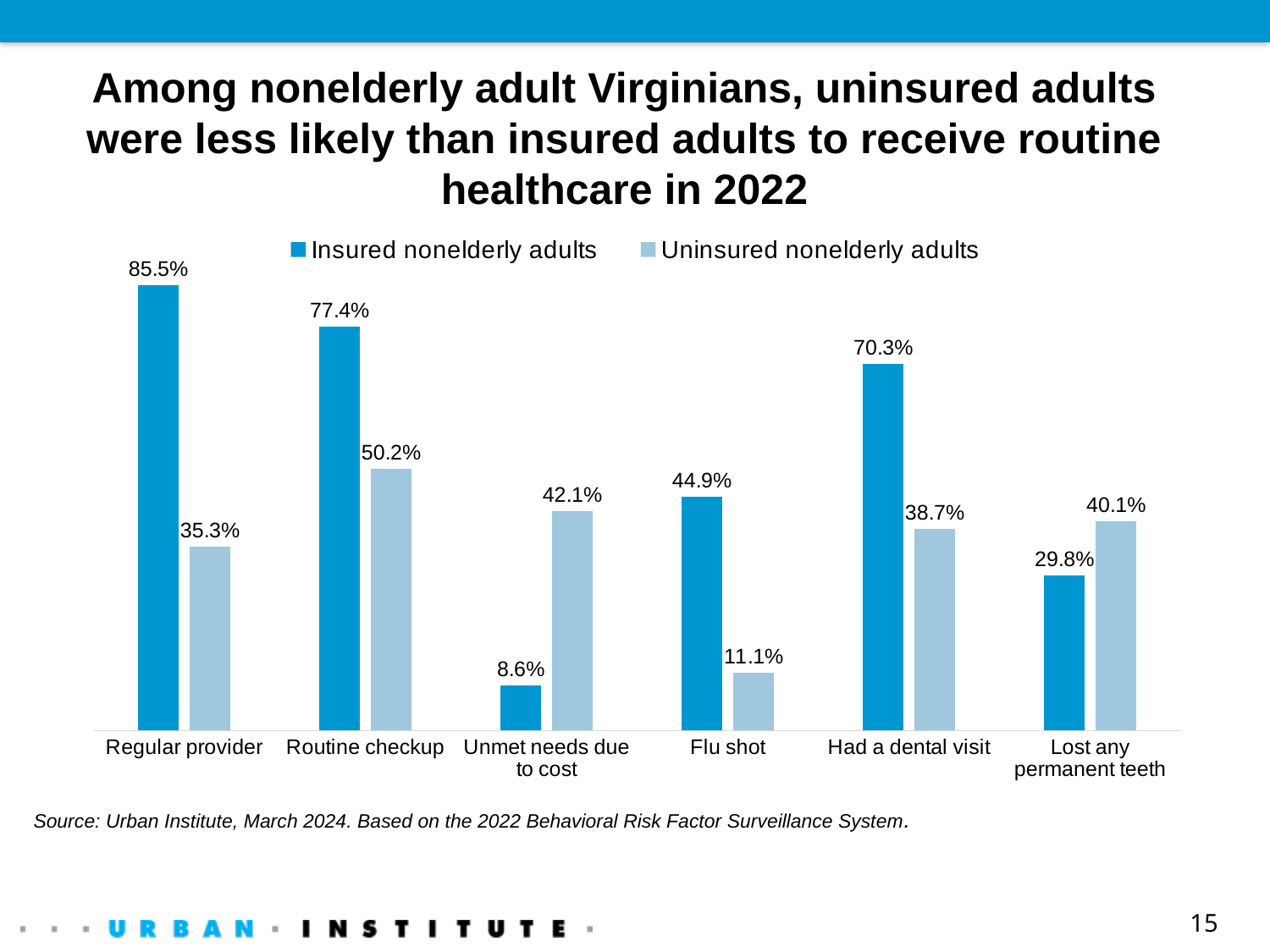
Which category has the lowest value for uninsured nonelderly adults? Flu shot What is the difference between insured and uninsured nonelderly adults in the Had a dental visit category? 31.6% In the Lost any permanent teeth category, which group has the larger value, insured or uninsured nonelderly adults? Uninsured nonelderly adults What is the source cited below the chart? Urban Institute, March 2024. Based on the 2022 Behavioral Risk Factor Surveillance System. Which category has the highest value for insured nonelderly adults? Regular provider What is the value for uninsured nonelderly adults in the Unmet needs due to cost category? 42.1% What is the value for insured nonelderly adults in the Regular provider category? 85.5% What is the value for uninsured nonelderly adults in the Flu shot category? 11.1% How many categories are shown on the x axis? 6 What is the difference between insured and uninsured nonelderly adults in the Routine checkup category? 27.2% What kind of chart is shown on the slide? Bar chart How many series does the legend list? 2